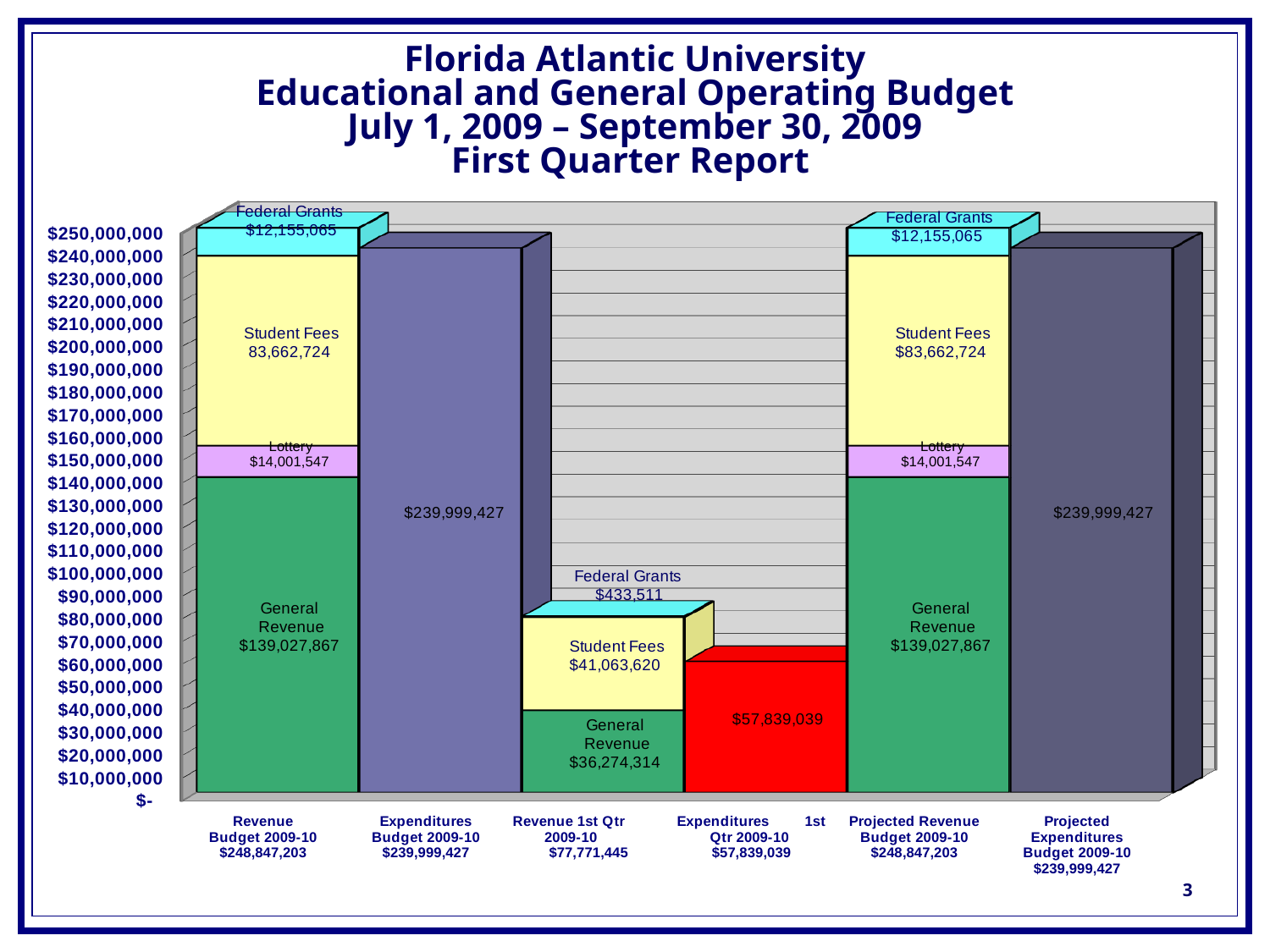
Which bar has the lowest total value? Expenditures 1st Qtr 2009-10 Is the value of the Expenditures 1st Qtr 2009-10 bar greater or less than $60,000,000? less What is the Lottery value in the Projected Revenue Budget 2009-10 bar? $14,001,547 In the Revenue 1st Qtr 2009-10 bar, which is larger: Student Fees or General Revenue? Student Fees What is the Student Fees value in the Revenue 1st Qtr 2009-10 bar? $41,063,620 How many bars are shown in the chart? 6 What is the difference between the Revenue 1st Qtr 2009-10 total and the Expenditures 1st Qtr 2009-10 value? $19,932,406 What is the difference between the Revenue Budget 2009-10 total and the Expenditures Budget 2009-10 value? $8,847,776 What is the total of the Revenue 1st Qtr 2009-10 stacked bar? $77,771,445 What is the Federal Grants value in the Revenue 1st Qtr 2009-10 bar? $433,511 What is the value of the Expenditures 1st Qtr 2009-10 bar? $57,839,039 What is the General Revenue value in the Revenue Budget 2009-10 bar? $139,027,867